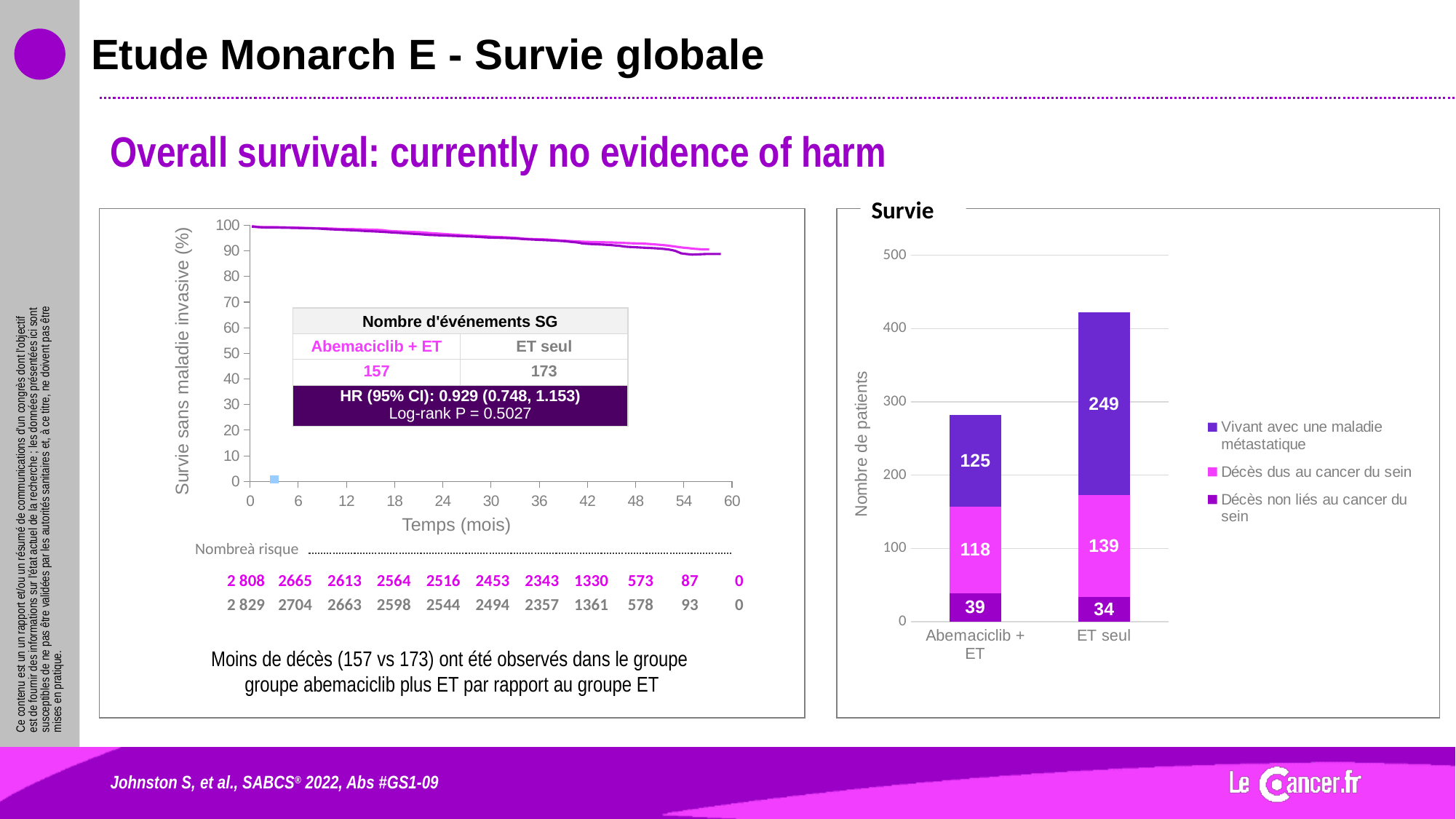
On the 'Survie' chart, what is the difference between the 'Vivant avec une maladie métastatique' values for 'ET seul' and 'Abemaciclib + ET'? 124 On the 'Survie' chart, what kind of chart is shown? stacked bar chart On the 'Survie' chart, how many series does the legend list? 3 On the 'Survie' chart, which category has the larger 'Décès dus au cancer du sein' value, 'Abemaciclib + ET' or 'ET seul'? ET seul On the 'Survie' chart, what is the value of 'Décès dus au cancer du sein' for 'ET seul'? 139 On the 'Survie' chart, how many categories are shown on the x axis? 2 On the 'Survie' chart, what is the value of 'Décès non liés au cancer du sein' for 'ET seul'? 34 On the 'Survie' chart, what is the total of the stacked bar for 'ET seul'? 422 On the 'Survie' chart, what is the total of the stacked bar for 'Abemaciclib + ET'? 282 On the left chart, what is the number of events (Nombre d'événements SG) for 'ET seul'? 173 On the 'Survie' chart, what is the value of 'Vivant avec une maladie métastatique' for 'Abemaciclib + ET'? 125 On the left chart, what is the label of the x axis? Temps (mois)